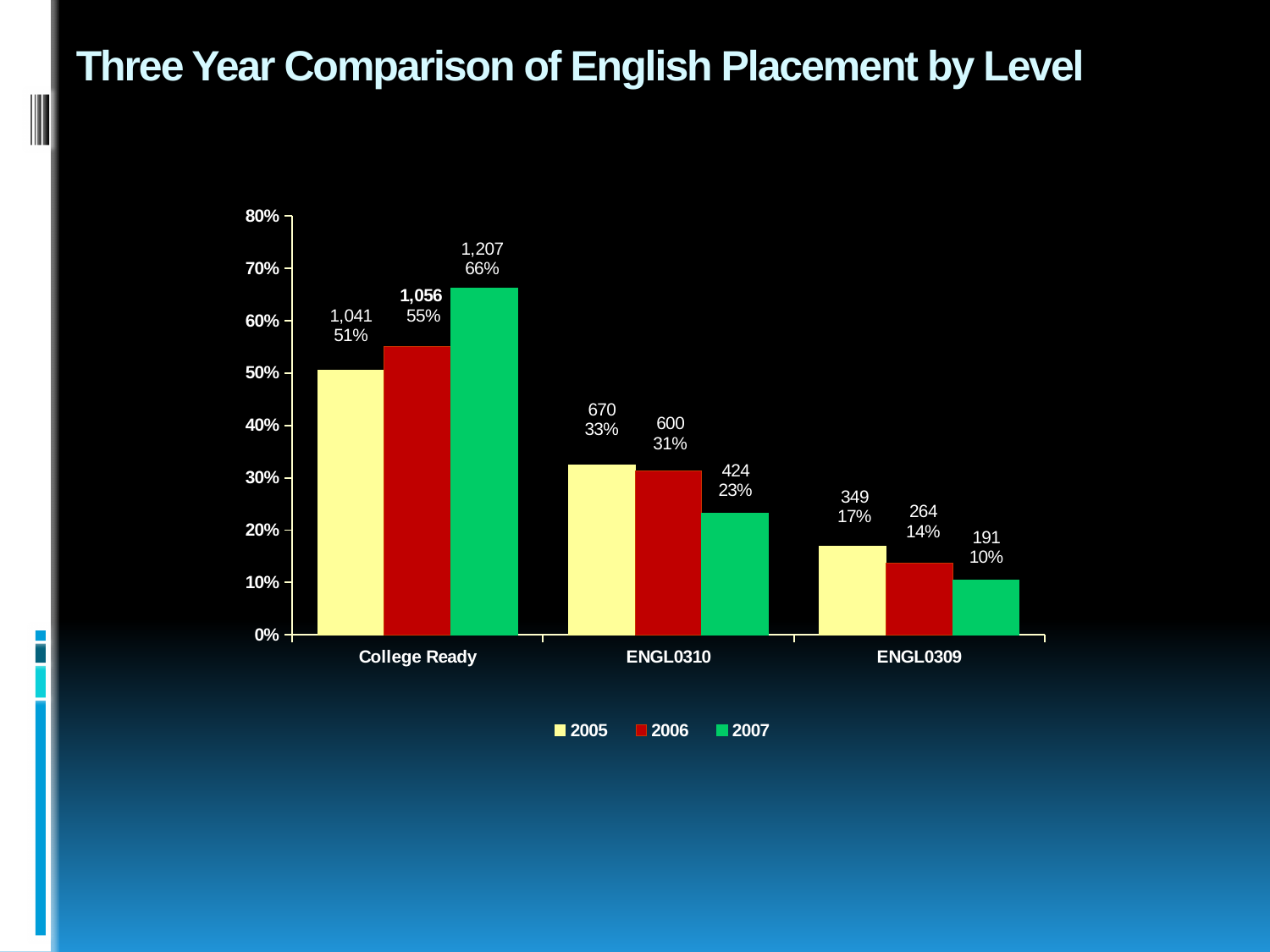
What percentage is shown for College Ready in 2007? 66% What kind of chart is shown on the slide? bar chart How many categories are shown on the x axis? 3 Which category has the highest value for the 2007 series? College Ready What count is shown for ENGL0310 in 2005? 670 Which is larger: the 2006 value for ENGL0310 or the 2006 value for ENGL0309? ENGL0310 Across the three years, does the percentage for ENGL0309 rise or fall from 2005 to 2007? fall Is the value for ENGL0310 in 2007 greater or less than 30%? less How many series does the legend list? 3 What is the difference in percentage points between College Ready in 2007 and College Ready in 2005? 15 What percentage is shown for ENGL0309 in 2006? 14% Which category has the lowest value for the 2005 series? ENGL0309